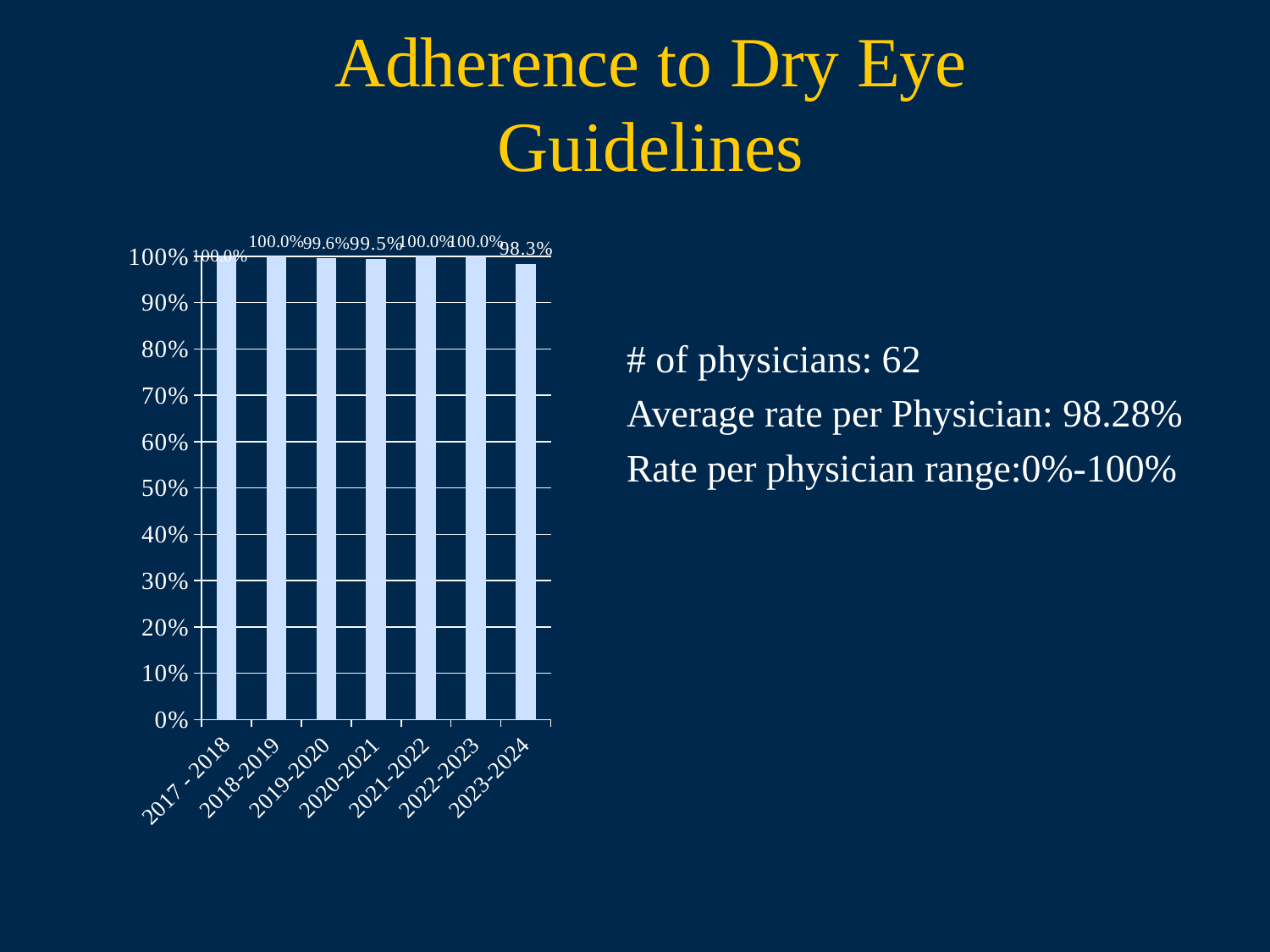
Is the value for 2023-2024 greater or less than 90%? greater What is the adherence rate shown for 2020-2021? 99.5% Which period has the lowest adherence rate? 2023-2024 What is the adherence rate shown for 2019-2020? 99.6% How many periods are shown on the x axis? 7 Which has the higher adherence rate, 2019-2020 or 2023-2024? 2019-2020 What is the adherence rate shown for 2023-2024? 98.3% What is the title of the slide containing the chart? Adherence to Dry Eye Guidelines What kind of chart is shown on the slide? bar chart What is the difference between the adherence rates for 2019-2020 and 2023-2024? 1.3% What is the adherence rate shown for 2021-2022? 100.0% Does the adherence rate rise or fall from 2022-2023 to 2023-2024? fall